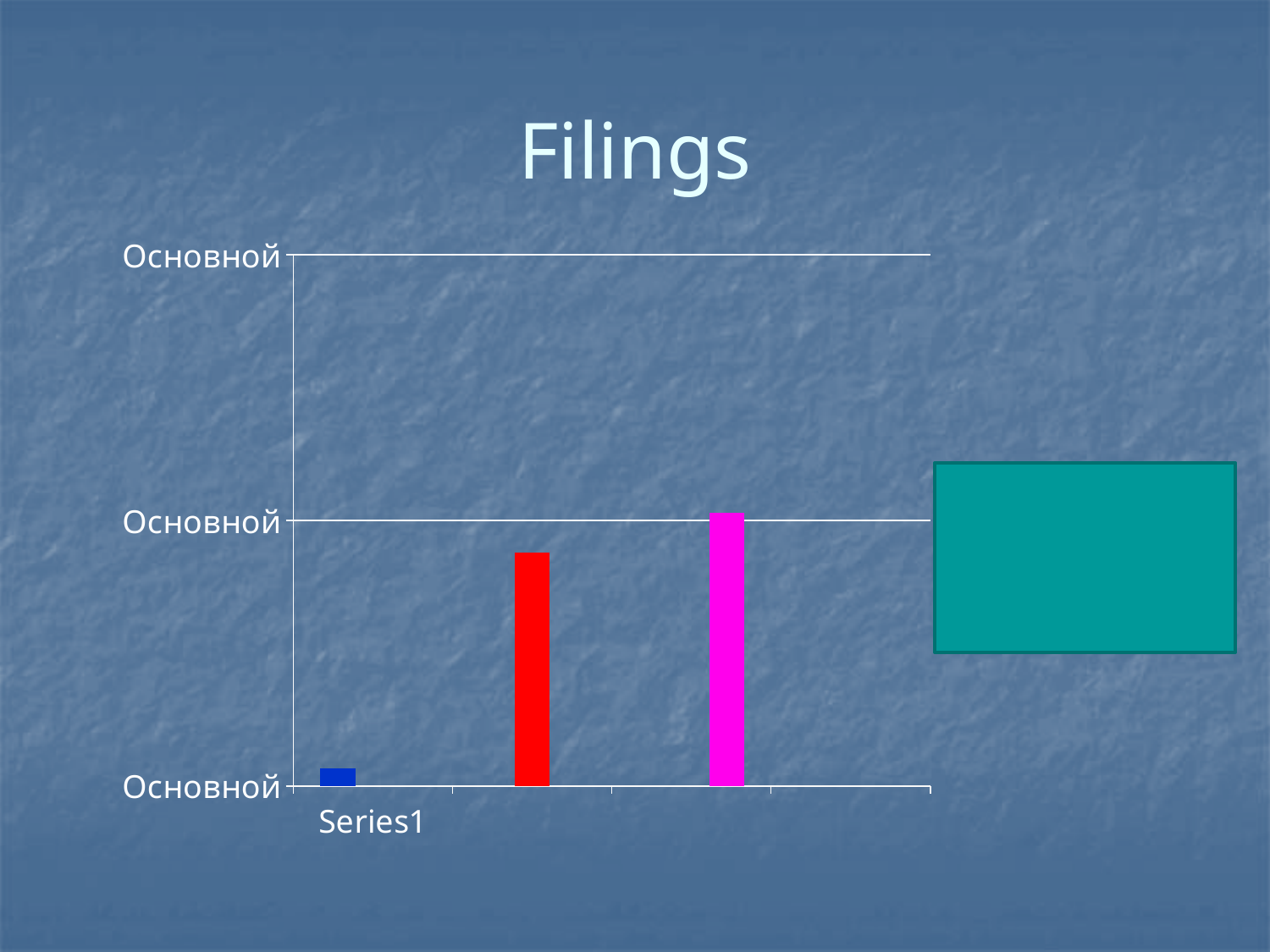
How many bars are plotted in the chart? 3 Which is taller, the red bar or the magenta bar? the magenta bar What label appears under the first bar on the x axis? Series1 Do the bar heights rise or fall from left to right across the chart? rise Which bar is the shortest in the chart? the blue bar What kind of chart is shown on the slide? bar chart Which is taller, the blue bar or the red bar? the red bar What is the title of the chart? Filings Which bar is the tallest in the chart? the magenta bar